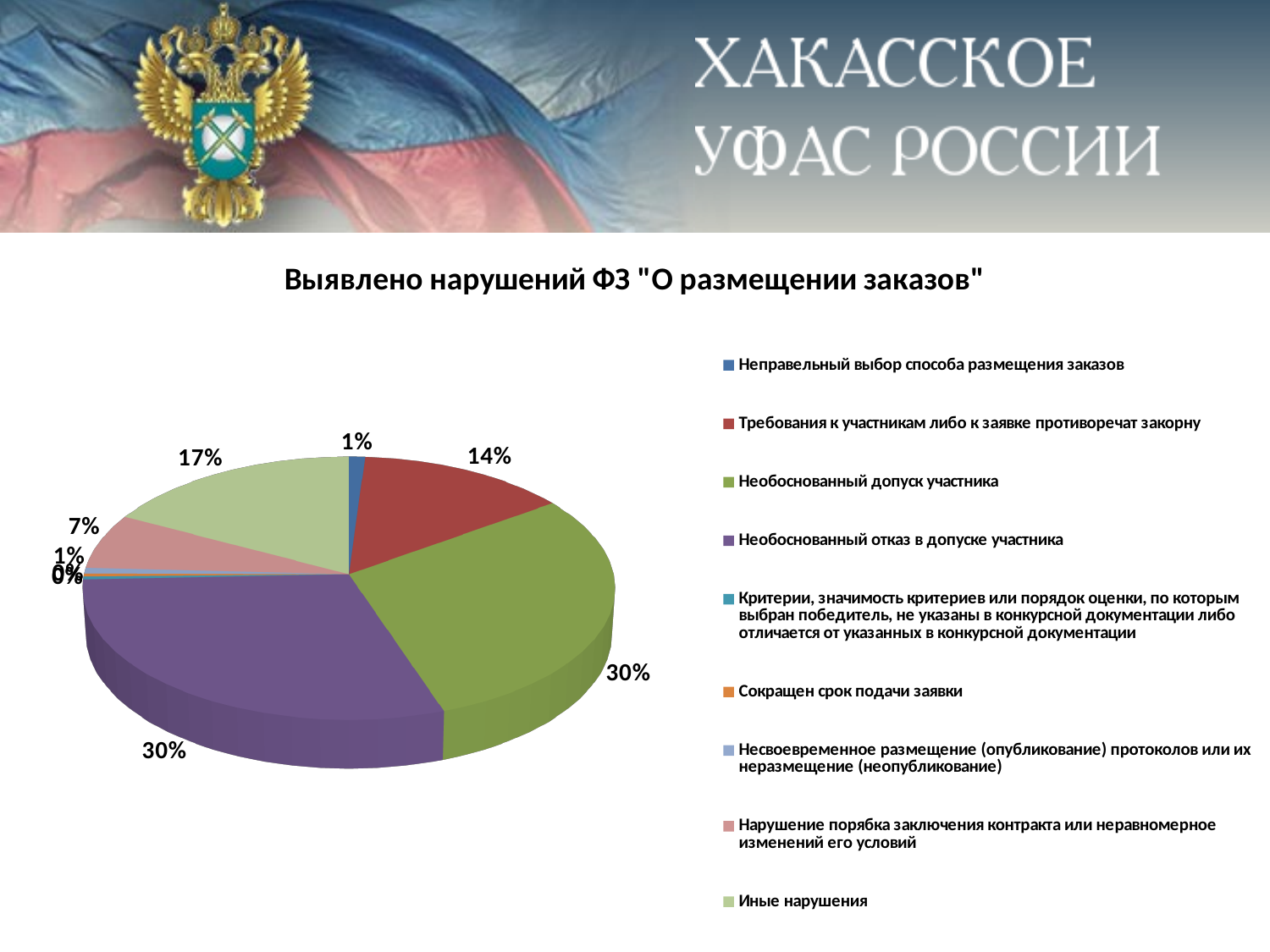
What percentage is shown for "Требования к участникам либо к заявке противоречат закорну"? 14% How many categories does the legend list? 9 Which slice is larger: "Необоснованный отказ в допуске участника" or "Нарушение порябка заключения контракта или неравномерное изменений его условий"? Необоснованный отказ в допуске участника What percentage is shown for "Неправельный выбор способа размещения заказов"? 1% What percentage is shown for "Необоснованный допуск участника"? 30% By how many percentage points does "Иные нарушения" exceed "Нарушение порябка заключения контракта или неравномерное изменений его условий"? 10 What share of the pie is labelled for "Иные нарушения"? 17% Which slice is larger: "Иные нарушения" or "Требования к участникам либо к заявке противоречат закорну"? Иные нарушения What percentage is shown for "Необоснованный отказ в допуске участника"? 30% What percentage is shown for "Нарушение порябка заключения контракта или неравномерное изменений его условий"? 7% What kind of chart is shown on the slide? pie chart What is the title of the chart? Выявлено нарушений ФЗ "О размещении заказов"